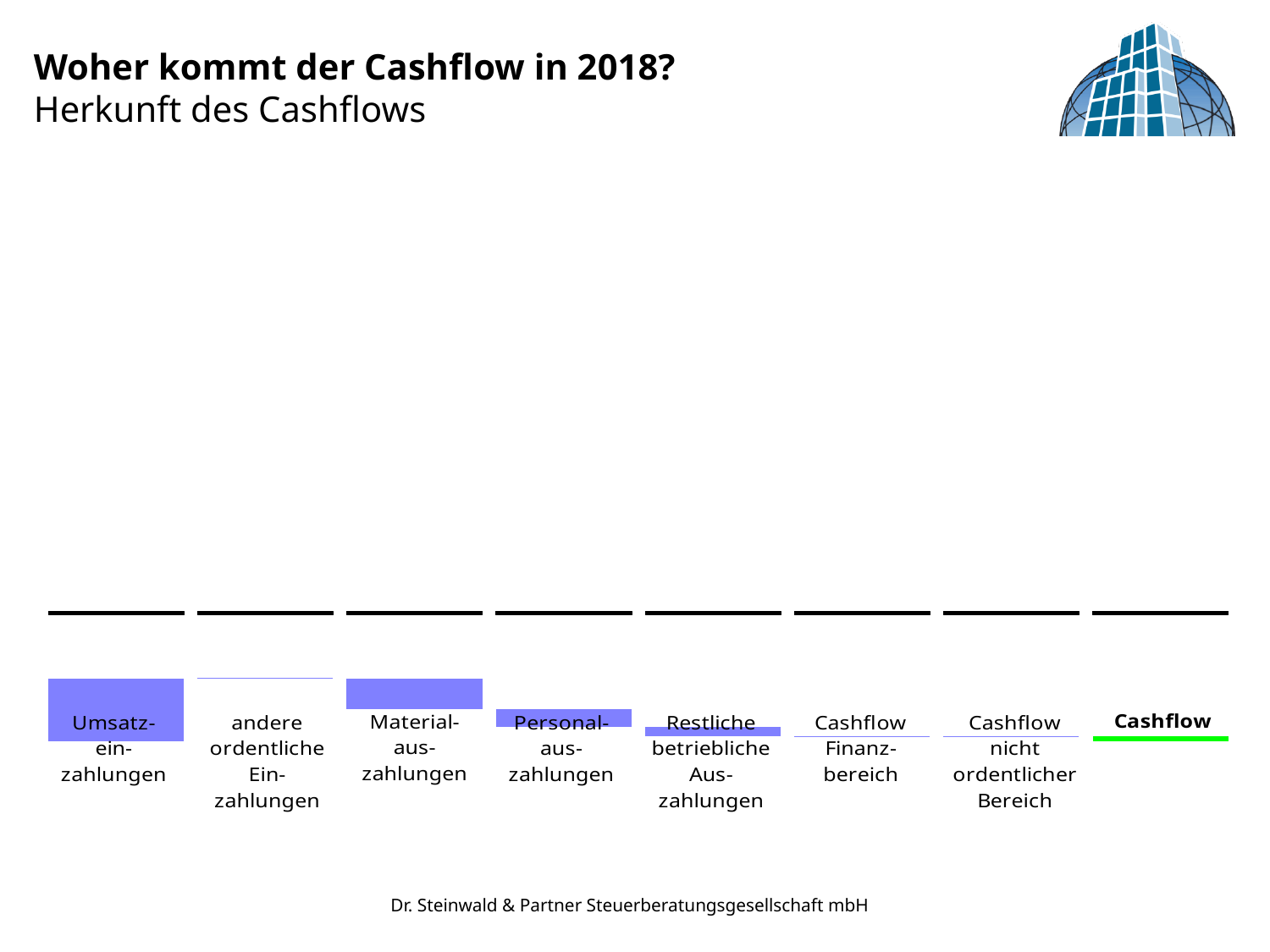
Which bar is taller: Materialauszahlungen or Personalauszahlungen? Materialauszahlungen Which category has the tallest bar in the chart? Umsatzeinzahlungen What is the title of the chart on the slide? Woher kommt der Cashflow in 2018? Which bar is taller: Materialauszahlungen or Restliche betriebliche Auszahlungen? Materialauszahlungen What is the subtitle shown under the chart title? Herkunft des Cashflows What is the label of the last (rightmost) category in the chart? Cashflow Which bar is taller: Umsatzeinzahlungen or Personalauszahlungen? Umsatzeinzahlungen What kind of chart is shown on the slide? bar chart How many categories are shown along the bottom of the chart? 8